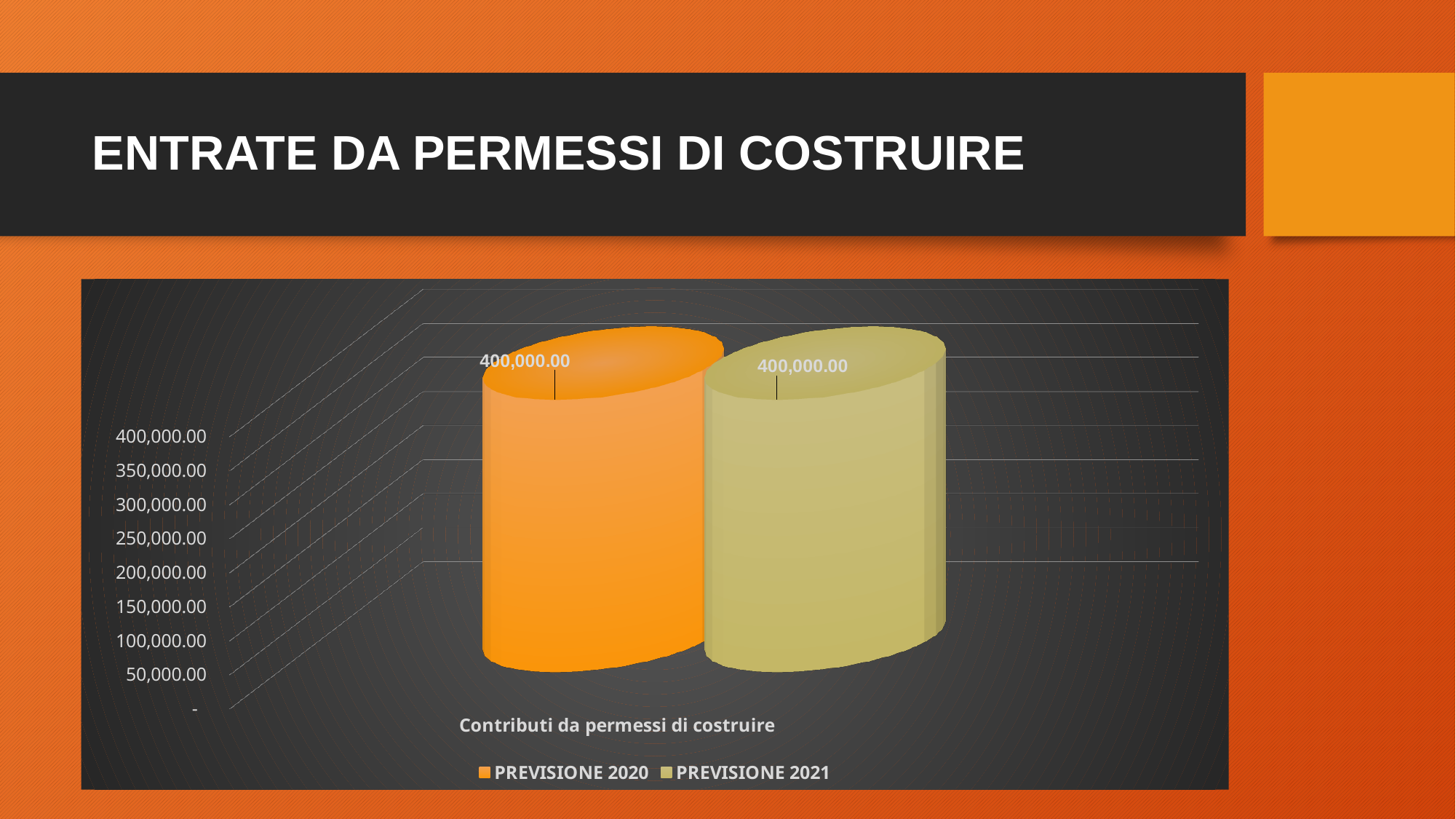
What is the value for PREVISIONE 2021 for Contributi da permessi di costruire? 400,000.00 Is the value for PREVISIONE 2020 greater or less than 300,000.00? greater What is the value for PREVISIONE 2020 for Contributi da permessi di costruire? 400,000.00 What kind of chart is shown on the slide? bar chart What is the total of the PREVISIONE 2020 and PREVISIONE 2021 values? 800,000.00 What is the difference between the PREVISIONE 2020 and PREVISIONE 2021 values? 0.00 How many categories are shown on the x axis? 1 Is the value for PREVISIONE 2021 greater or less than 350,000.00? greater What is the category label shown on the x axis? Contributi da permessi di costruire How many series does the legend list? 2 Which series is shown in orange in the legend? PREVISIONE 2020